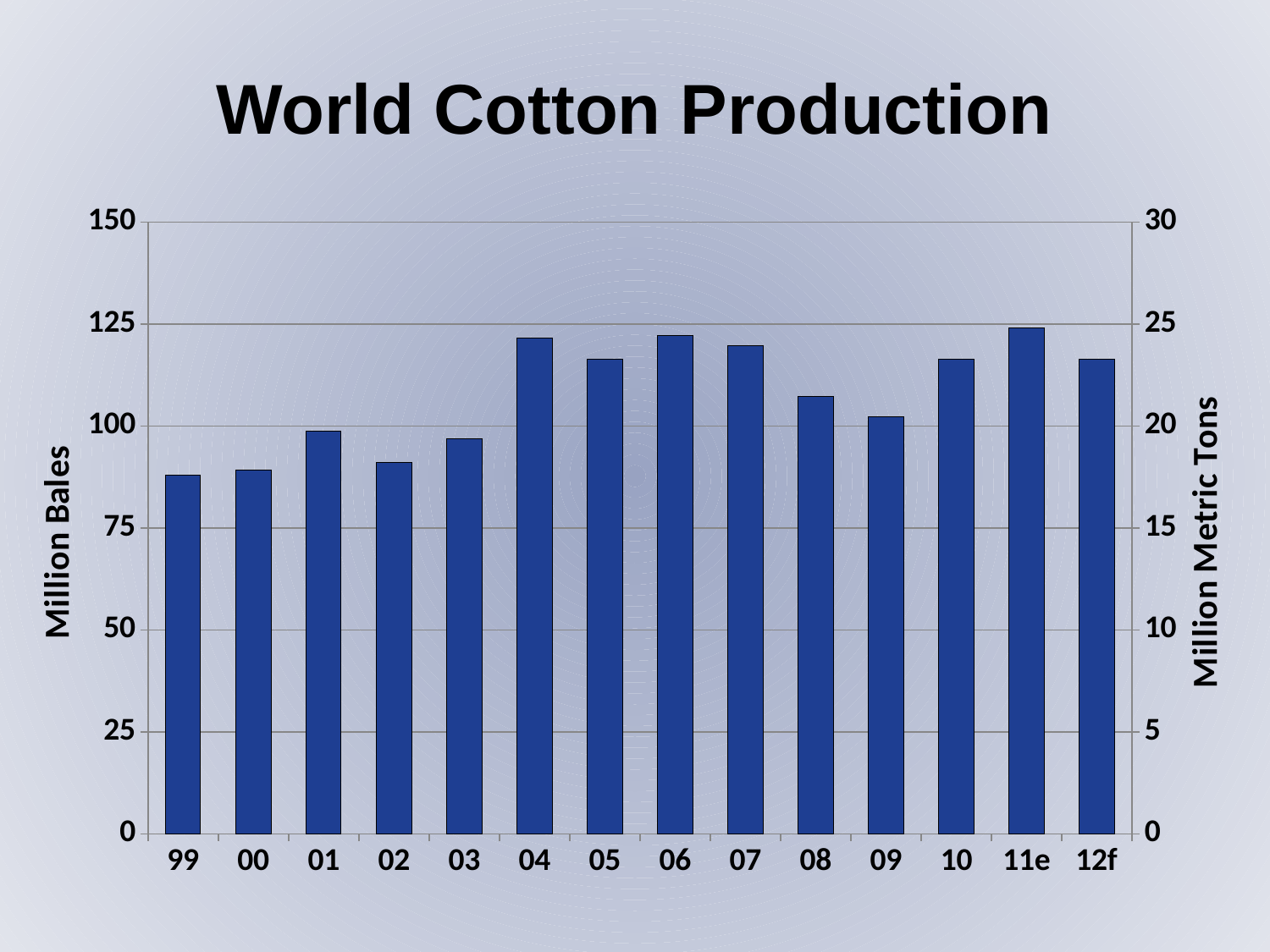
Do the values rise or fall from 99 to 04? rise Is the value for 08 greater or less than 125 million bales? less Is the value for 99 greater or less than 100 million bales? less Is the value for 04 greater or less than 100 million bales? greater Which is larger, the value for 08 or the value for 09? 08 What kind of chart is shown on the slide? bar chart Which is larger, the value for 04 or the value for 99? 04 How many years (categories) are plotted on the x axis? 14 Which year has the highest world cotton production? 11e What is the label of the left vertical axis? Million Bales What is the label of the right vertical axis? Million Metric Tons